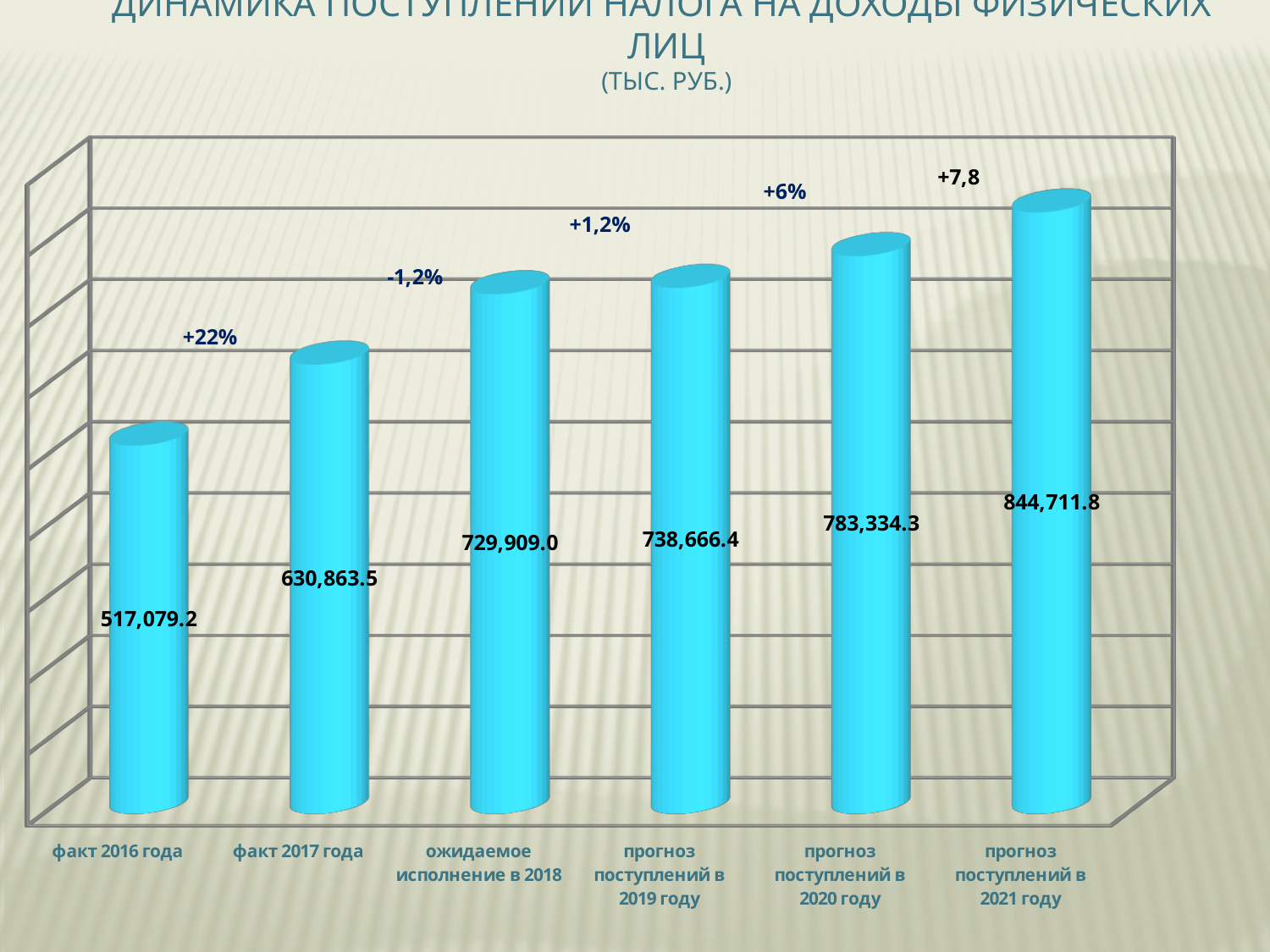
What is the difference between the values for прогноз поступлений в 2021 году and факт 2016 года? 327,632.6 What is the difference between the values for факт 2017 года and факт 2016 года? 113,784.3 Do the values rise or fall from left to right along the x axis? rise Which category has the lowest value? факт 2016 года What is the value for факт 2016 года? 517,079.2 What kind of chart is shown on the slide? bar chart Which is larger, the value for прогноз поступлений в 2020 году or the value for ожидаемое исполнение в 2018? прогноз поступлений в 2020 году Which category has the highest value? прогноз поступлений в 2021 году What is the value for прогноз поступлений в 2021 году? 844,711.8 What is the value for прогноз поступлений в 2020 году? 783,334.3 What is the value for факт 2017 года? 630,863.5 How many categories are shown on the chart? 6